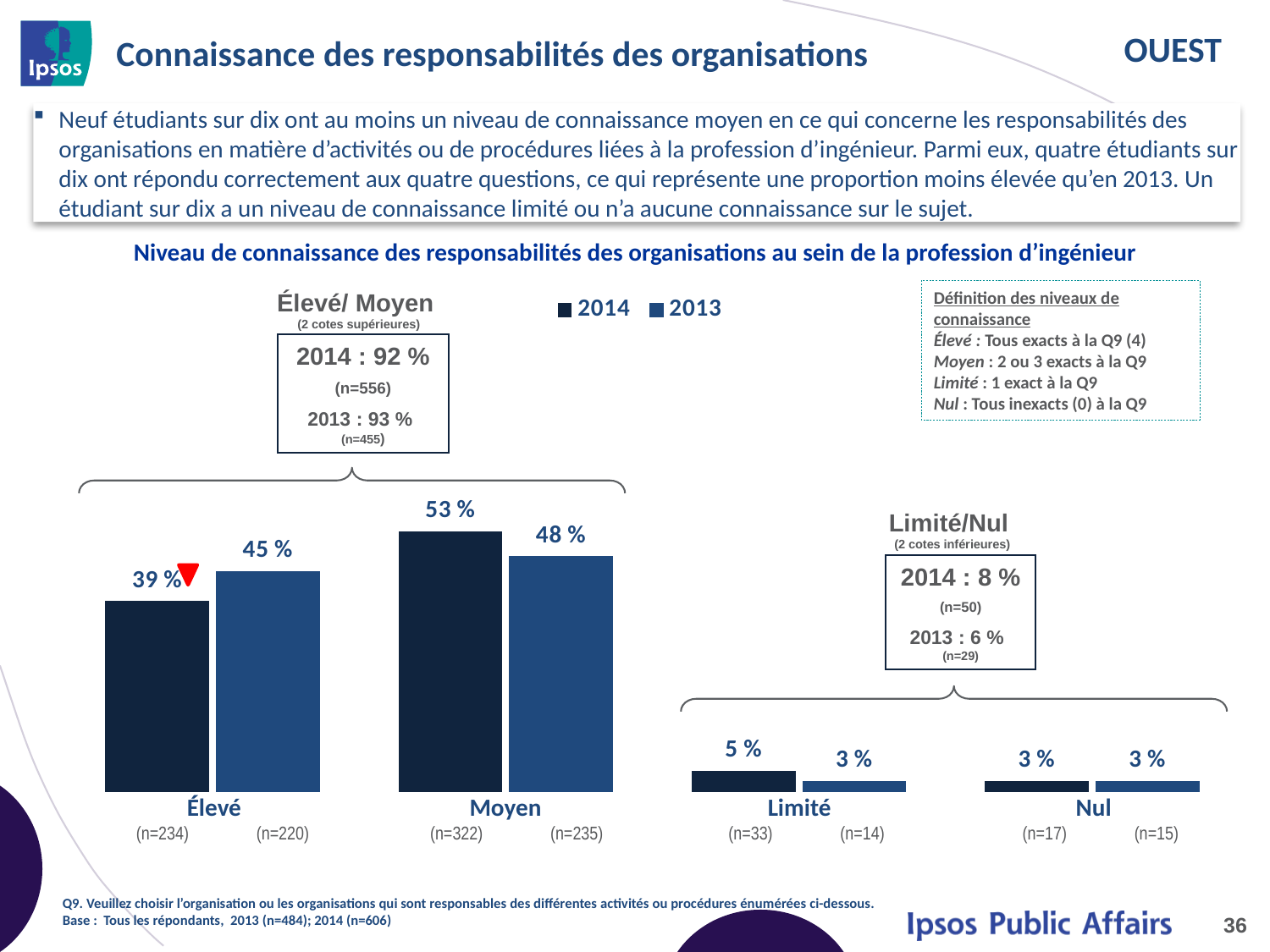
Which is larger for Élevé, the 2014 value or the 2013 value? 2013 What is the title of the chart? Niveau de connaissance des responsabilités des organisations au sein de la profession d'ingénieur What is the value for Élevé in 2014? 39 % What kind of chart is shown on the slide? Bar chart What is the value for Limité in 2014? 5 % What is the difference between the 2014 and 2013 values for Moyen? 5 % How many series does the legend list? 2 Which category has the lowest value for 2014? Nul Which category has the highest value for 2014? Moyen What is the value for Moyen in 2013? 48 % What is the difference between the 2013 and 2014 values for Élevé? 6 % How many categories are shown on the x axis of the chart? 4